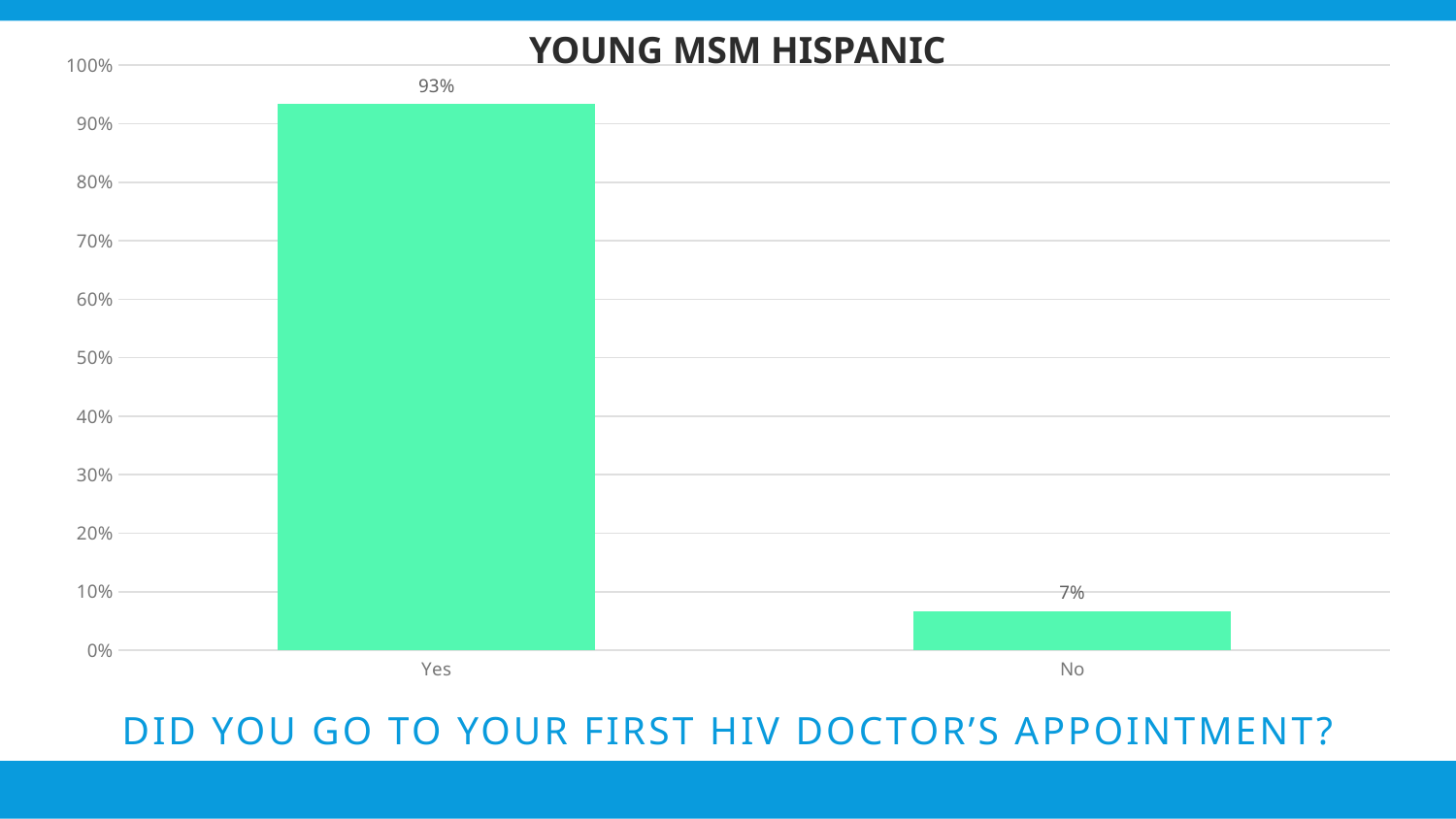
How many categories are shown on the x axis? 2 What is the maximum value shown on the y axis? 100% What percentage of respondents answered No? 7% What is the difference between the Yes and No percentages? 86% Which category has the lowest value? No Is the value for Yes greater or less than 90%? greater What is the title of the chart? YOUNG MSM HISPANIC Which is larger, the value for Yes or the value for No? Yes What kind of chart is shown on the slide? Bar chart Which category has the highest value? Yes Is the value for No greater or less than 10%? less What percentage of respondents answered Yes? 93%